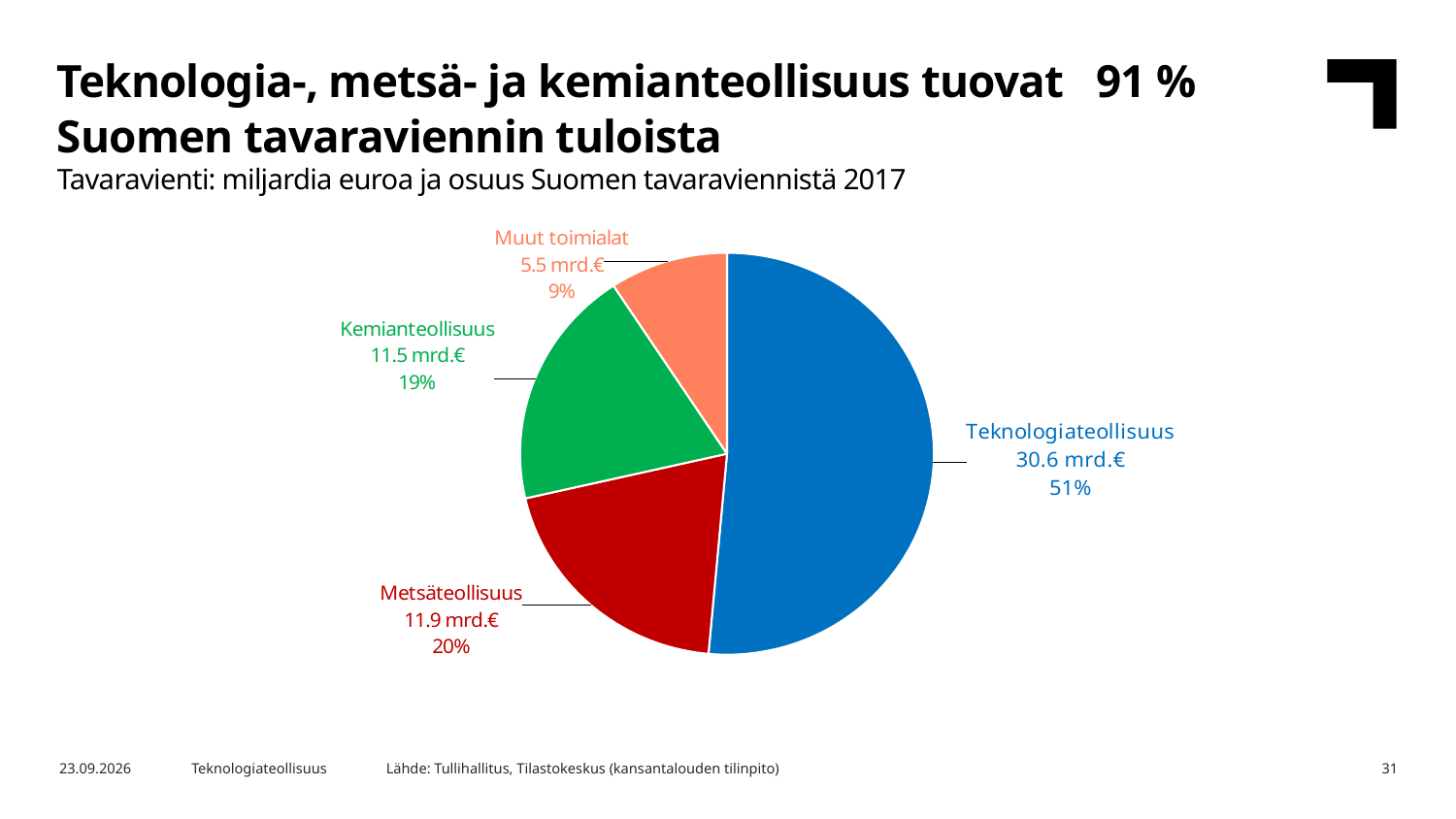
What is the difference in export value between Metsäteollisuus and Kemianteollisuus? 0.4 mrd.€ Which has a larger export value, Teknologiateollisuus or Metsäteollisuus? Teknologiateollisuus What is the difference in export value between Teknologiateollisuus and Muut toimialat? 25.1 mrd.€ What kind of chart is shown on the slide? Pie chart What is the export value shown for Teknologiateollisuus? 30.6 mrd.€ What is the export value shown for Kemianteollisuus? 11.5 mrd.€ How many slices does the pie chart have? 4 Which sector has the largest slice of the pie? Teknologiateollisuus Which sector has the smallest slice of the pie? Muut toimialat What colour is the Kemianteollisuus slice? Green What share of the pie does Muut toimialat represent? 9% What share of the pie does Metsäteollisuus represent? 20%